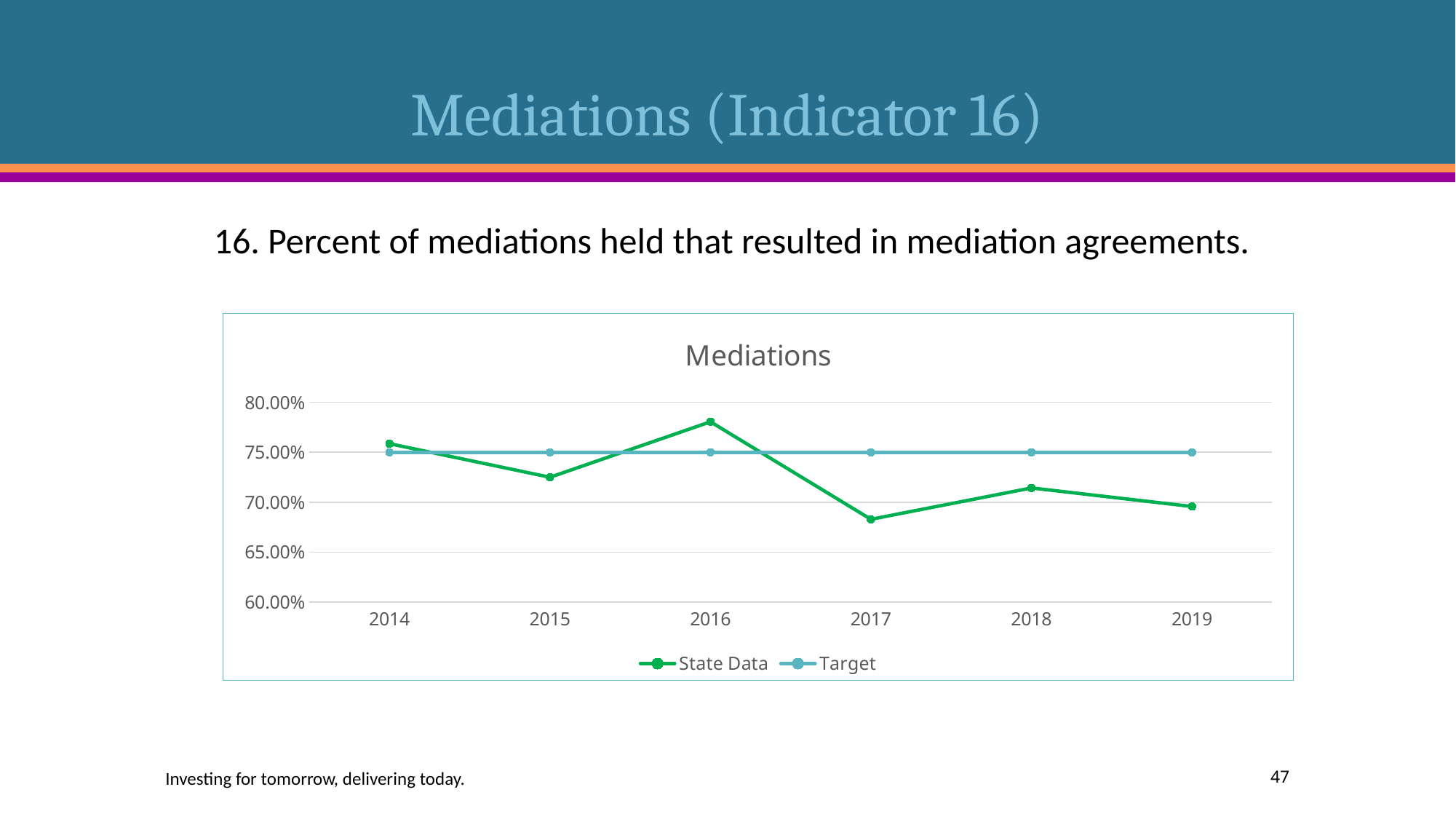
Which year has the larger State Data value, 2016 or 2017? 2016 Is the State Data value for 2017 greater or less than 70.00%? less What kind of chart is shown on the slide? line chart Is the State Data value for 2015 greater or less than 75.00%? less How many years are plotted along the x axis of the chart? 6 In which year is the State Data value lowest? 2017 Is the State Data value for 2016 greater or less than 75.00%? greater How many series does the chart legend list? 2 Does the State Data line rise or fall from 2016 to 2017? fall In which year is the State Data value highest? 2016 What is the title of the chart? Mediations What is the Target value shown for 2017? 75.00%